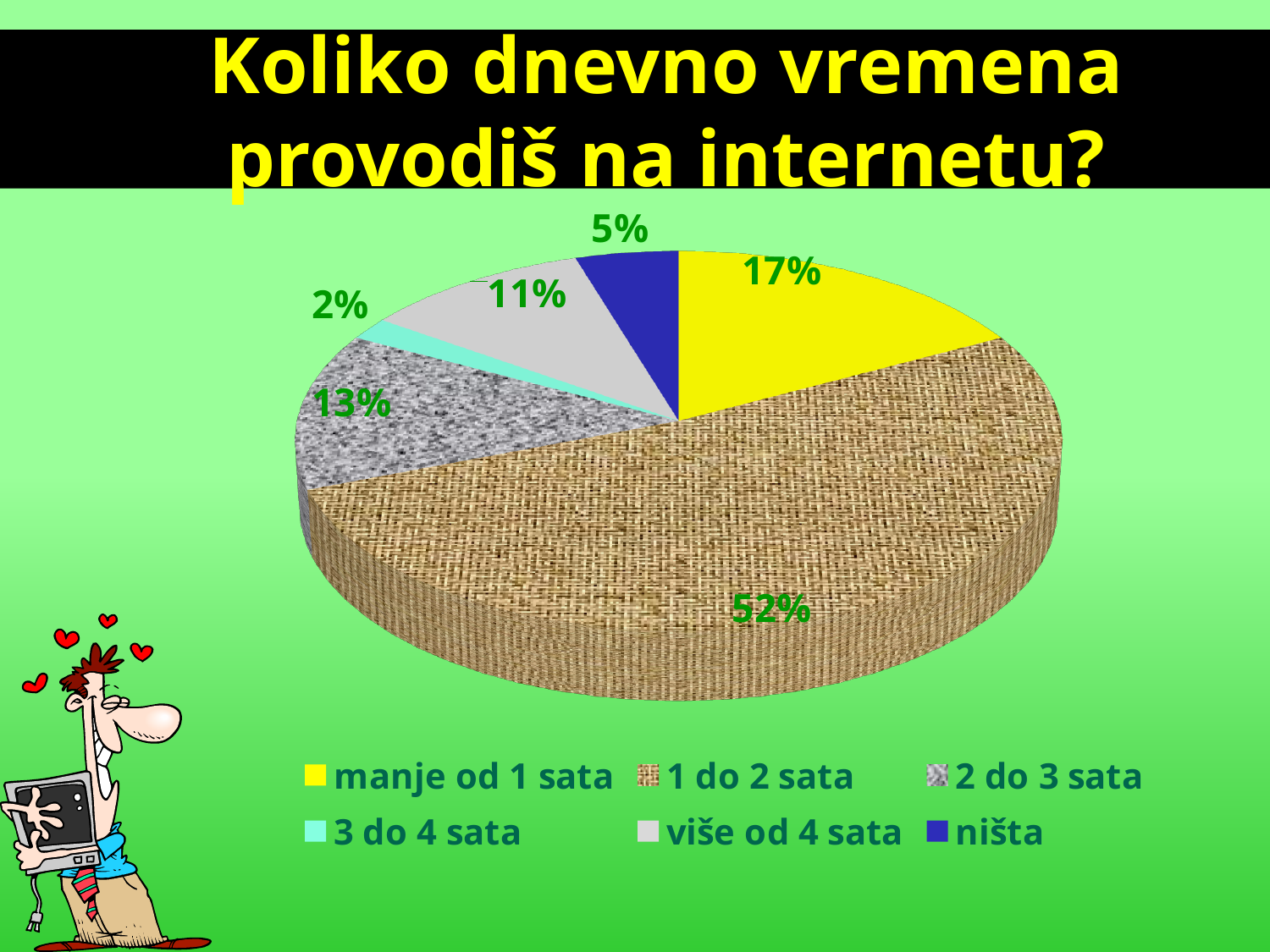
What is the difference in percentage points between the '1 do 2 sata' and 'manje od 1 sata' slices? 35 What kind of chart is shown on the slide? pie chart How many categories does the legend list? 6 What percentage is shown for the '3 do 4 sata' slice? 2% What percentage is shown for the 'manje od 1 sata' slice? 17% What percentage of respondents spend 1 do 2 sata on the internet daily? 52% Which is larger, the share for '2 do 3 sata' or the share for 'više od 4 sata'? 2 do 3 sata What is the title of the chart on the slide? Koliko dnevno vremena provodiš na internetu? Which category has the smallest share of the pie? 3 do 4 sata Which category has the largest share of the pie? 1 do 2 sata What percentage is shown for the 'više od 4 sata' slice? 11% What percentage is shown for the 'ništa' slice? 5%